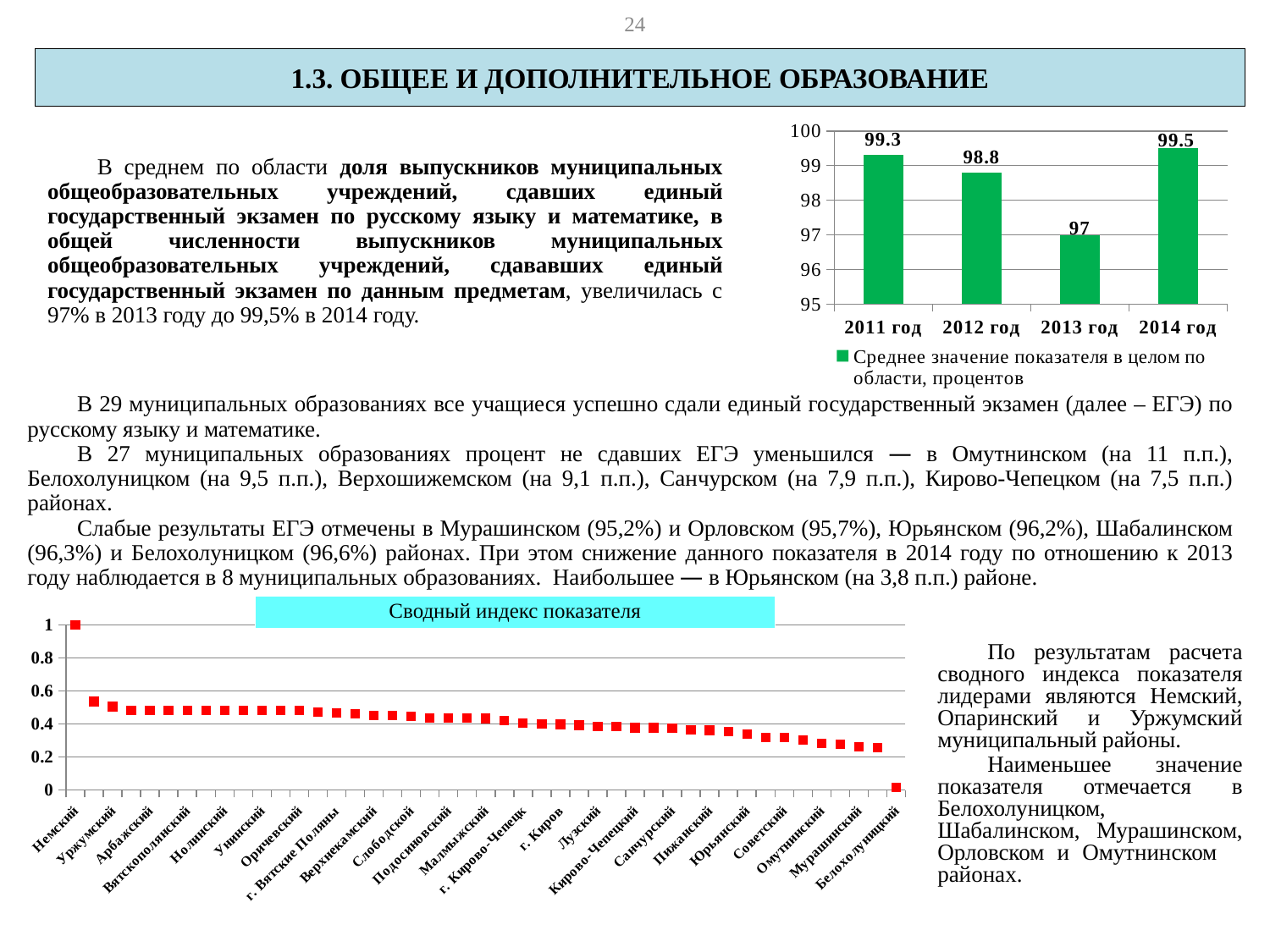
In the chart titled 'Сводный индекс показателя', is the value for Белохолуницкий greater or less than 0.2? less In the chart titled 'Сводный индекс показателя', do the values rise or fall from left to right along the x axis? fall In the bar chart in the top right, what is the difference between the values for 2014 год and 2013 год? 2.5 In the bar chart in the top right, which year has the highest value? 2014 год In the bar chart in the top right, what is the value for 2011 год? 99.3 In the bar chart in the top right, what is the value for 2014 год? 99.5 In the bar chart in the top right, which year has the lowest value? 2013 год What type of chart is shown in the top right of the slide? Bar chart In the bar chart in the top right, which is larger, the value for 2011 год or 2012 год? 2011 год In the chart titled 'Сводный индекс показателя', is the value for Немский greater or less than 0.8? greater In the bar chart in the top right, what is the value for 2013 год? 97 How many bars are shown in the bar chart in the top right? 4